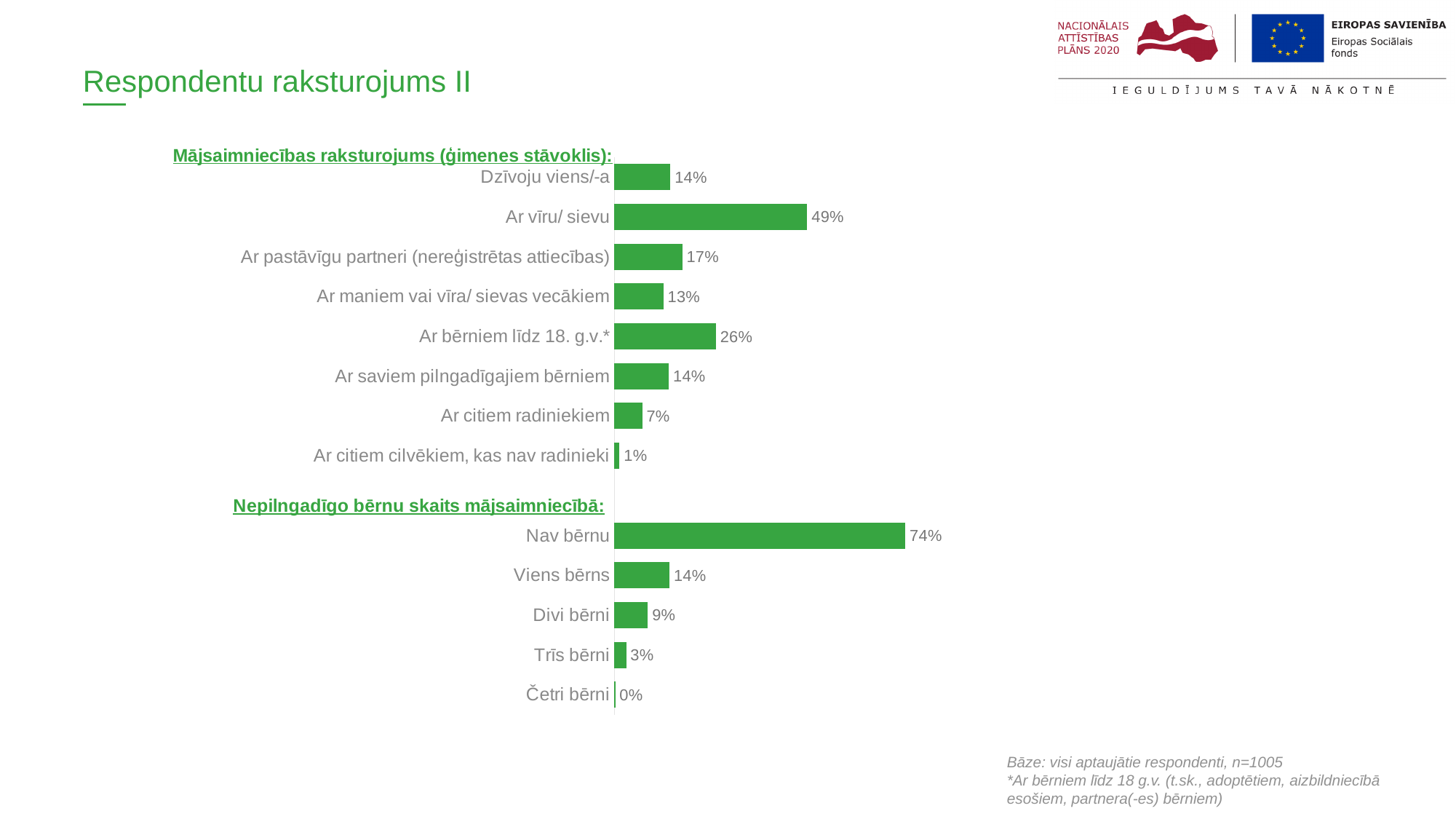
Which category in the 'Mājsaimniecības raksturojums (ģimenes stāvoklis)' section has the highest value? Ar vīru/ sievu What is the value for 'Trīs bērni'? 3% Which category in the 'Nepilngadīgo bērnu skaits mājsaimniecībā' section has the lowest value? Četri bērni How many categories are listed under 'Nepilngadīgo bērnu skaits mājsaimniecībā'? 5 What colour are the bars in the chart? Green What is the difference between the values for 'Nav bērnu' and 'Viens bērns'? 60% How many bars are plotted in total on the chart? 13 What percentage of respondents live with a husband/wife (Ar vīru/ sievu)? 49% What percentage is shown for 'Ar bērniem līdz 18. g.v.*'? 26% What type of chart is shown on the slide? Bar chart Which is larger: the value for 'Ar pastāvīgu partneri (nereģistrētas attiecības)' or for 'Ar maniem vai vīra/ sievas vecākiem'? Ar pastāvīgu partneri (nereģistrētas attiecības) What is the value shown for 'Nav bērnu'? 74%